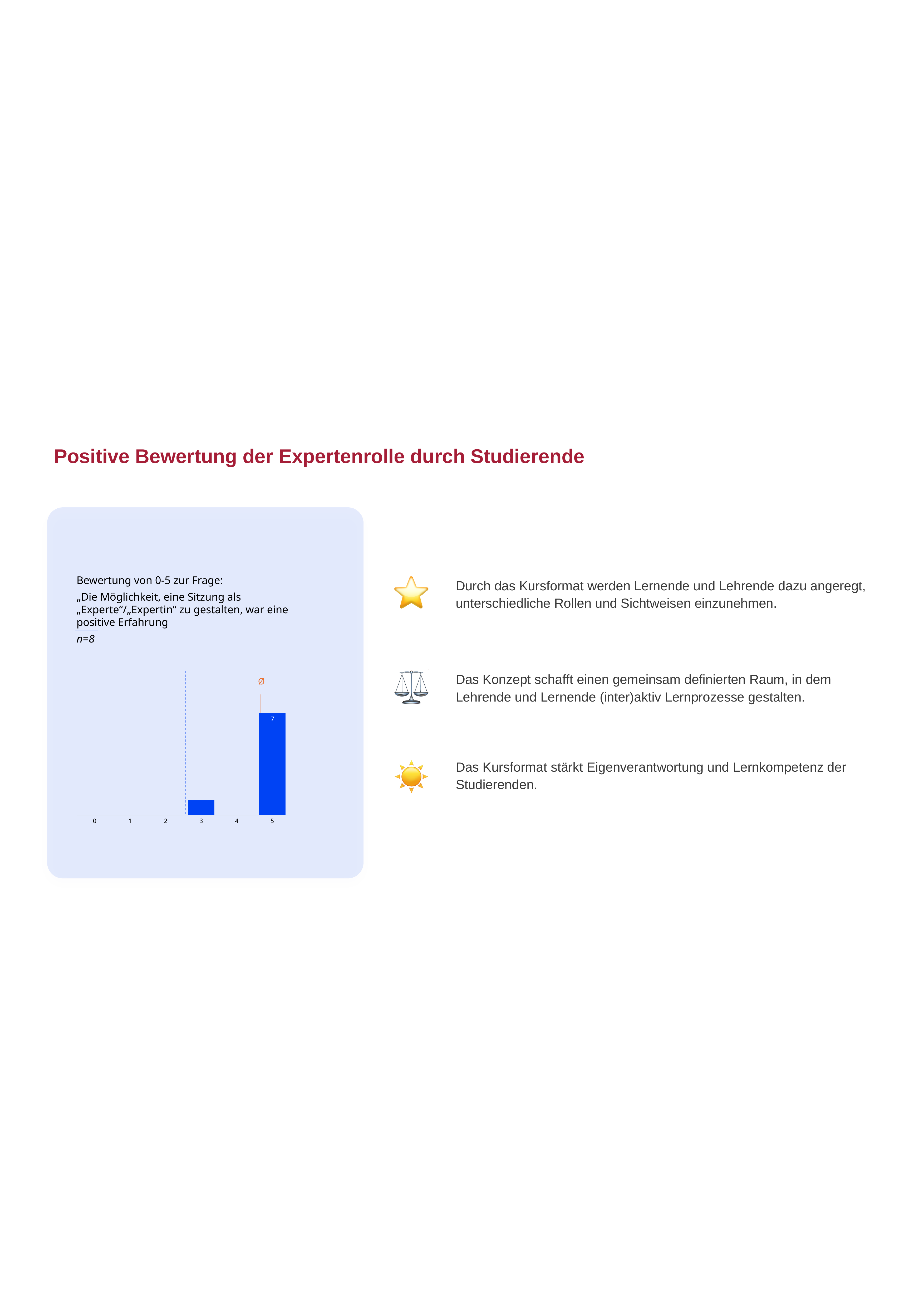
What kind of chart is shown on the slide? bar chart What is the value of the bar for rating 5? 7 How many rating categories have a visible bar? 2 Which rating category has the highest bar? 5 What rating scale does the chart text say was used? 0-5 How many rating categories are shown on the x axis? 6 What is the sample size (n) stated for the chart? n=8 Which bar is taller, the one for rating 3 or the one for rating 5? 5